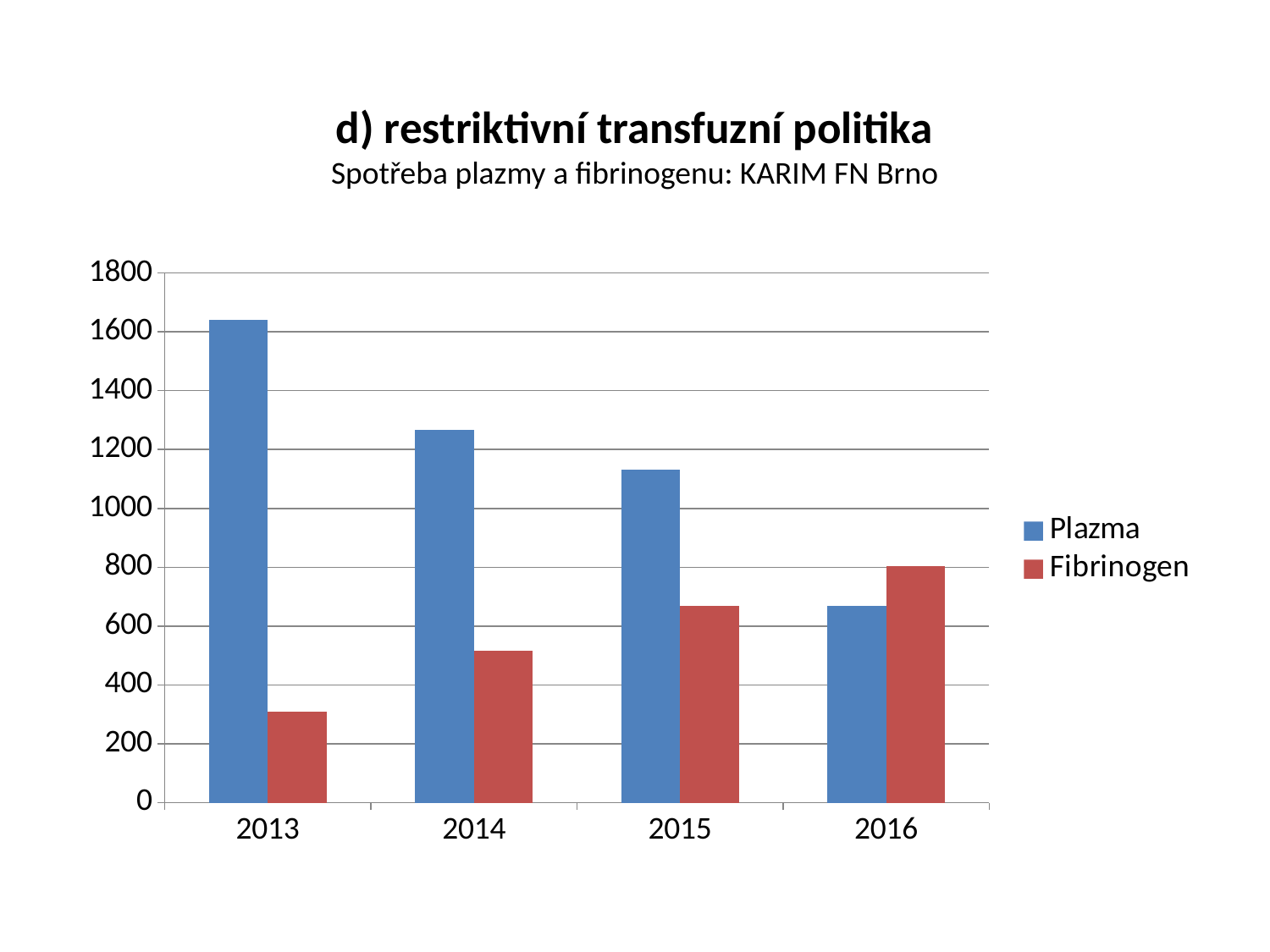
In 2016, which is larger, Plazma or Fibrinogen? Fibrinogen What kind of chart is shown on the slide? bar chart Is the Plazma value for 2013 greater or less than 1400? greater Do the Plazma values rise or fall from 2013 to 2016? fall In which year is the Fibrinogen value lowest? 2013 How many series does the legend list? 2 In which year is the Fibrinogen value highest? 2016 In which year is the Plazma value lowest? 2016 Do the Fibrinogen values rise or fall from 2013 to 2016? rise In which year is the Plazma value highest? 2013 How many years are shown on the x axis? 4 Is the Fibrinogen value for 2013 greater or less than 400? less